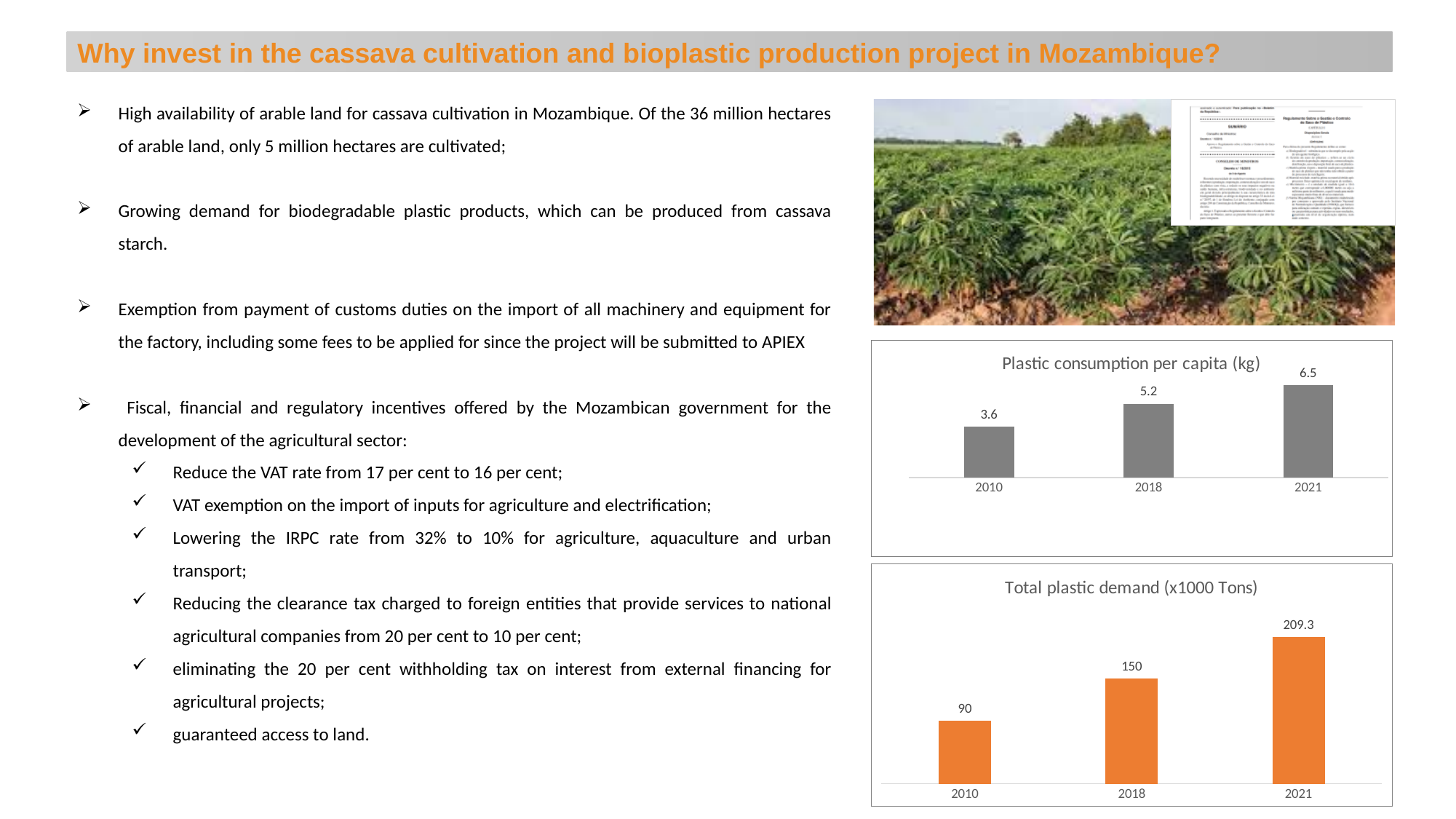
In the 'Plastic consumption per capita (kg)' chart, which year has the lowest value? 2010 In the 'Plastic consumption per capita (kg)' chart, what is the value for 2018? 5.2 In the 'Plastic consumption per capita (kg)' chart, what is the difference between the 2021 and 2010 values? 2.9 In the 'Total plastic demand (x1000 Tons)' chart, what is the difference between the 2018 and 2010 values? 60 In the 'Plastic consumption per capita (kg)' chart, do the values rise or fall from 2010 to 2021? rise In the 'Total plastic demand (x1000 Tons)' chart, what is the value for 2021? 209.3 In the 'Total plastic demand (x1000 Tons)' chart, what is the value for 2010? 90 What colour are the bars in the 'Total plastic demand (x1000 Tons)' chart? orange In the 'Plastic consumption per capita (kg)' chart, which year has the highest value? 2021 In the 'Total plastic demand (x1000 Tons)' chart, which is larger, the value for 2018 or the value for 2021? 2021 What kind of chart is the 'Total plastic demand (x1000 Tons)' chart? bar chart In the 'Plastic consumption per capita (kg)' chart, how many years are plotted? 3